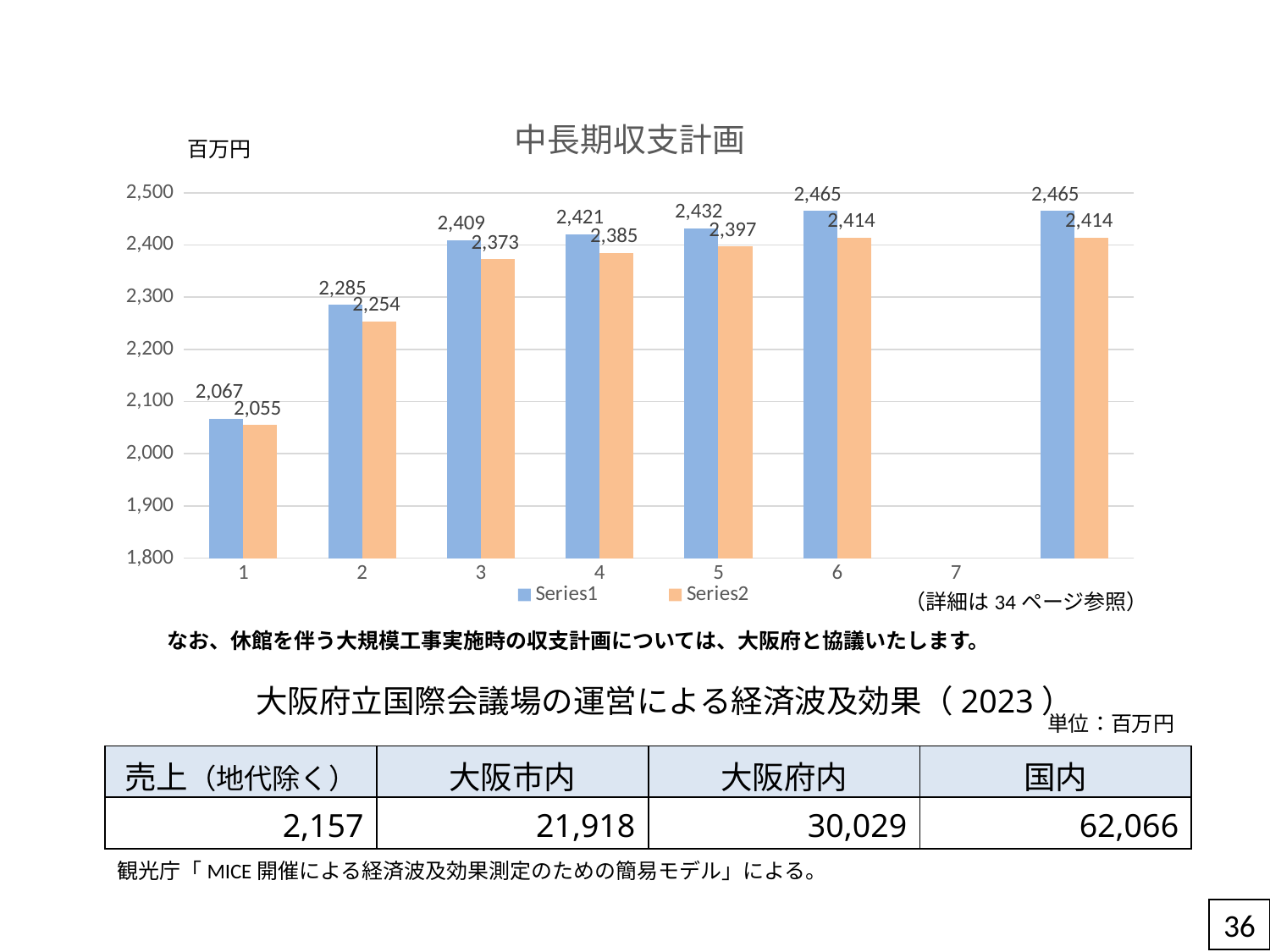
What is the title of the chart? 中長期収支計画 What is the Series1 value for category 5? 2,432 What is the Series2 value for category 3? 2,373 What is the Series2 value for category 6? 2,414 For category 4, which series has the larger value, Series1 or Series2? Series1 What is the difference between the Series1 and Series2 values for category 2? 31 What is the Series1 value for category 1? 2,067 How many series does the legend of the 中長期収支計画 chart list? 2 Which category has the lowest Series1 value? 1 Do the Series2 values rise or fall from category 1 to category 6? rise What kind of chart is shown on the slide? bar chart By how much does the Series1 value for category 6 exceed the Series1 value for category 1? 398